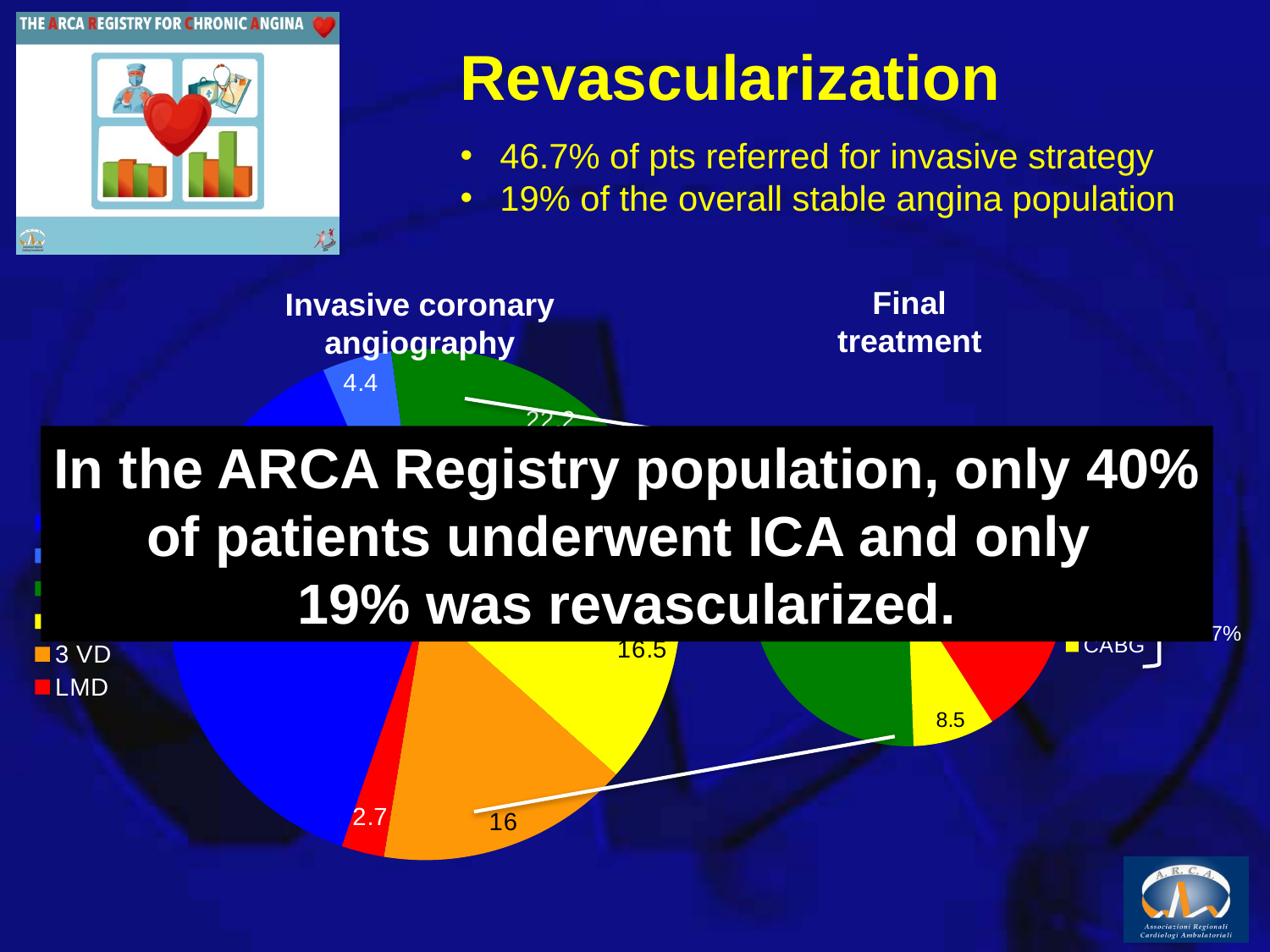
In the 'Invasive coronary angiography' chart, what is the difference between the values for 3 VD and LMD? 13.3 In the 'Invasive coronary angiography' chart, what is the value for LMD? 2.7 What kind of chart is the 'Invasive coronary angiography' chart? pie chart In the 'Invasive coronary angiography' chart, what is the value for 3 VD? 16 What kind of chart is the 'Final treatment' chart? pie chart In the 'Invasive coronary angiography' chart, which is larger, 3 VD or LMD? 3 VD In the 'Final treatment' chart, what value is printed on the yellow slice? 8.5 What is the title of the chart on the right side of the slide? Final treatment What is the title of the chart on the left side of the slide? Invasive coronary angiography How many charts are shown on the slide? 2